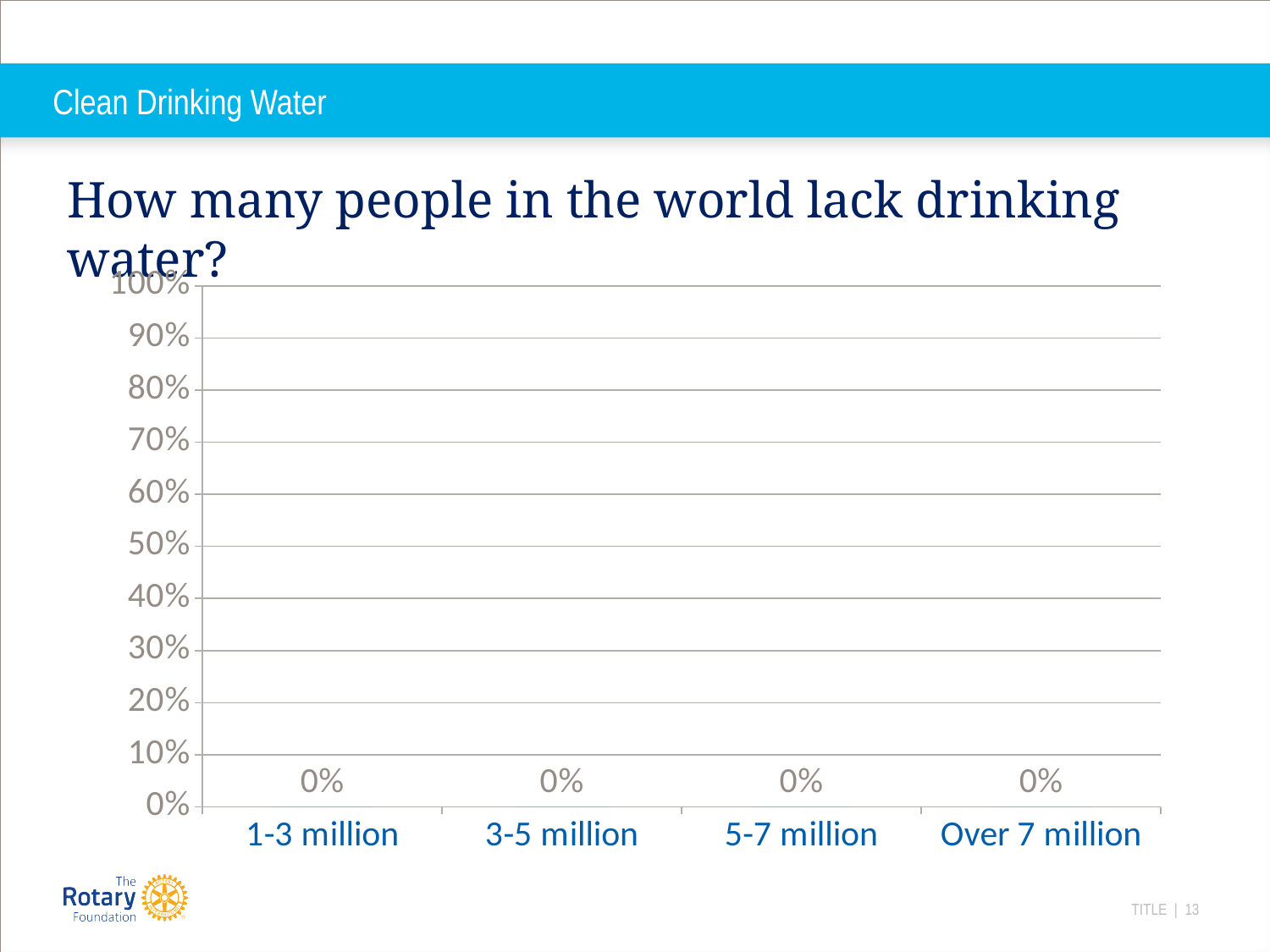
What is the title of the slide containing the chart? How many people in the world lack drinking water? What is the value for the 1-3 million category? 0% What is the difference between the values for 1-3 million and Over 7 million? 0% Is the value for 3-5 million greater or less than 10%? less What is the value for the 3-5 million category? 0% What is the value for the Over 7 million category? 0% What is the value for the 5-7 million category? 0% How many categories are shown on the x axis of the chart? 4 Is the value for Over 7 million greater or less than 50%? less What is the highest value shown on the y axis of the chart? 100% What is the label of the last category on the x axis? Over 7 million